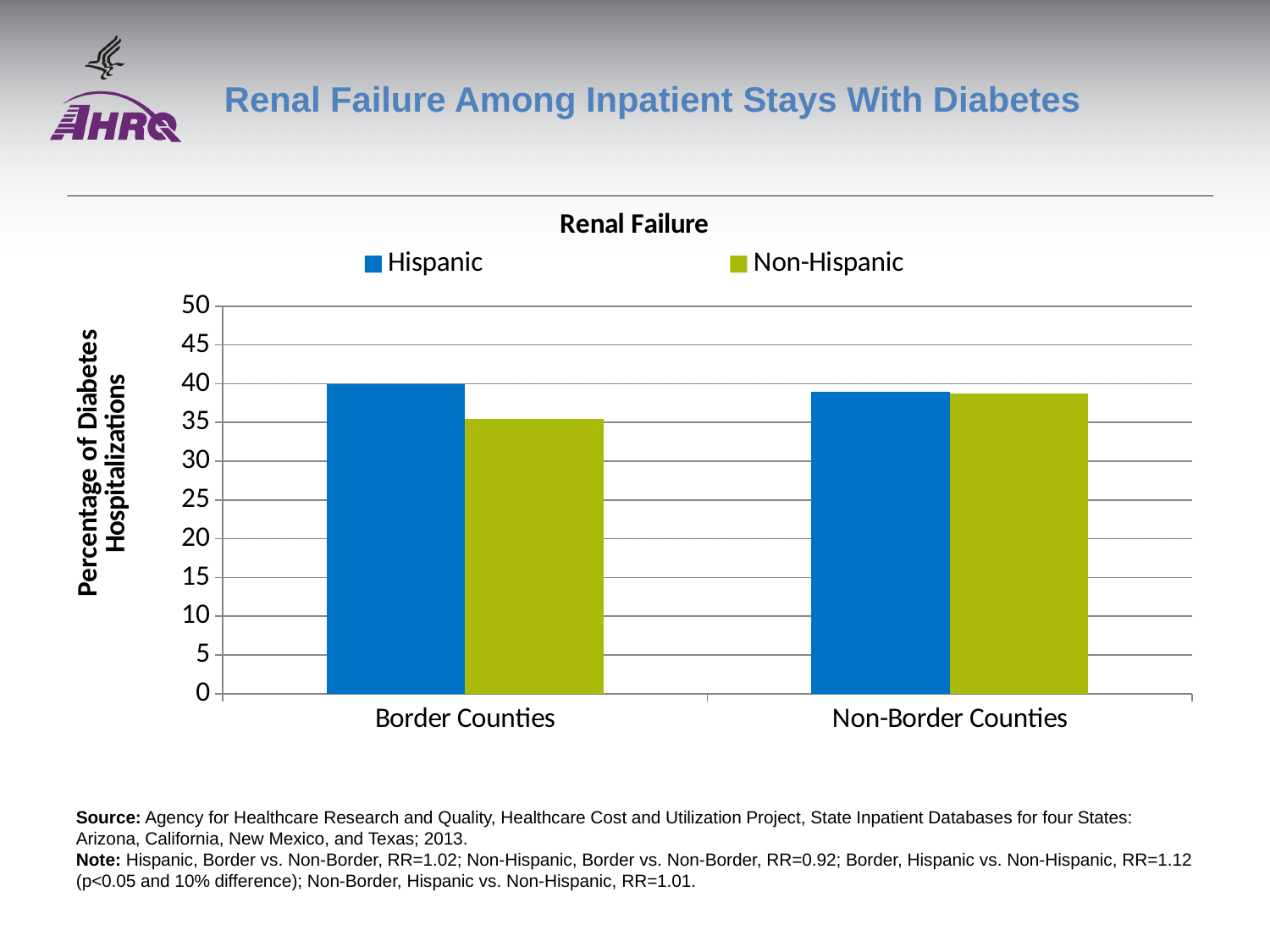
Is the Non-Hispanic value for Border Counties greater or less than 30? greater Is the Hispanic value for Border Counties greater or less than 35? greater In Border Counties, which is larger: the Hispanic value or the Non-Hispanic value? Hispanic Which series has the lowest bar in the chart? Non-Hispanic, Border Counties What is the title of the chart? Renal Failure What is the label on the y axis of the chart? Percentage of Diabetes Hospitalizations What kind of chart is shown on the slide? Bar chart Is the Non-Hispanic value for Border Counties greater or less than 40? less How many series does the legend list? 2 How many categories are shown on the x axis? 2